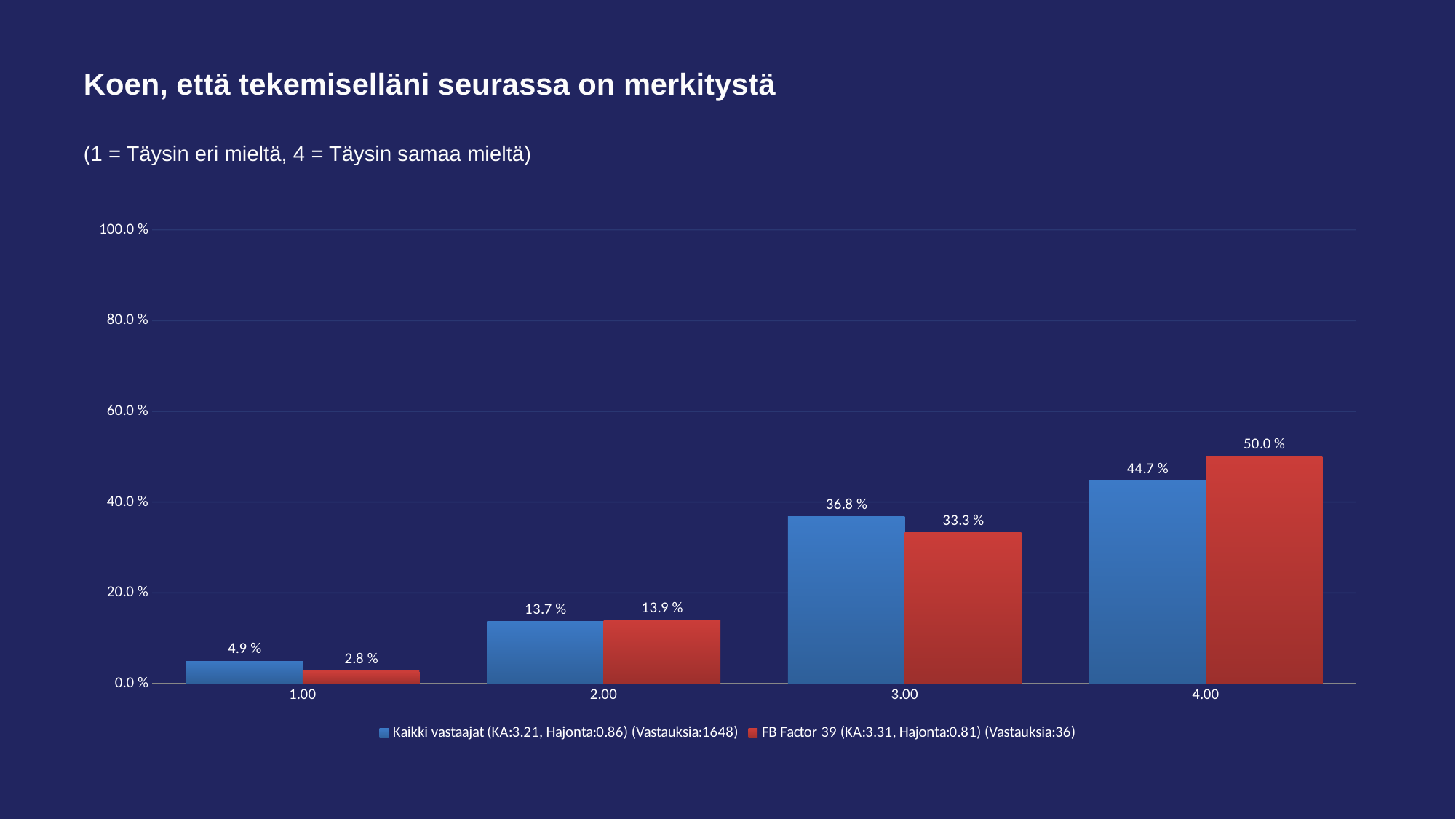
What is the value for FB Factor 39 at 3.00? 33.3 % Do the values for Kaikki vastaajat rise or fall from 1.00 to 4.00? Rise At 3.00, which series has the larger value, Kaikki vastaajat or FB Factor 39? Kaikki vastaajat What is the value for Kaikki vastaajat at 1.00? 4.9 % Which category has the lowest value for FB Factor 39? 1.00 Which category has the highest value for Kaikki vastaajat? 4.00 What kind of chart is shown on the slide? Bar chart What is the value for Kaikki vastaajat at 2.00? 13.7 % What is the difference between the FB Factor 39 and Kaikki vastaajat values at 4.00? 5.3 % How many categories are shown on the x axis? 4 How many series does the legend list? 2 What is the value for FB Factor 39 at 4.00? 50.0 %